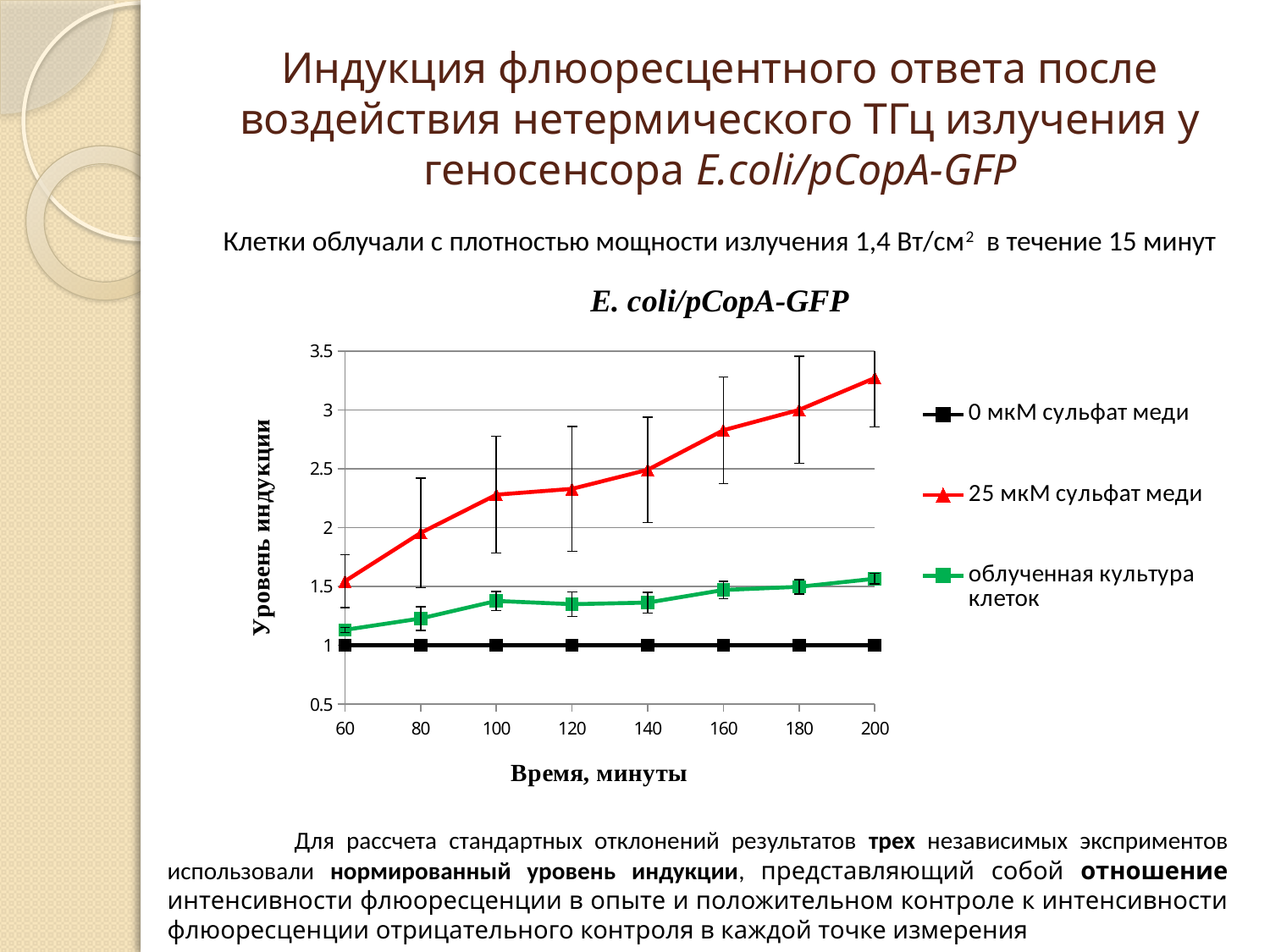
How many time points are plotted along the x axis? 8 Is the value for "25 мкМ сульфат меди" at 60 minutes greater or less than 2? less Is the value for "25 мкМ сульфат меди" at 200 minutes greater or less than 3? greater What is the label of the x axis of the chart? Время, минуты Is the value for "облученная культура клеток" at 200 minutes greater or less than 2? less At 100 minutes, which series has the larger value: "25 мкМ сульфат меди" or "облученная культура клеток"? 25 мкМ сульфат меди What is the value of the "0 мкМ сульфат меди" series at 60 minutes? 1 How many series does the legend list? 3 What kind of chart is shown on the slide? line chart Which series has the highest value at 200 minutes? 25 мкМ сульфат меди Does the "25 мкМ сульфат меди" series rise or fall as time increases from 60 to 200 minutes? rise Which series has the lowest values across the whole time range? 0 мкМ сульфат меди